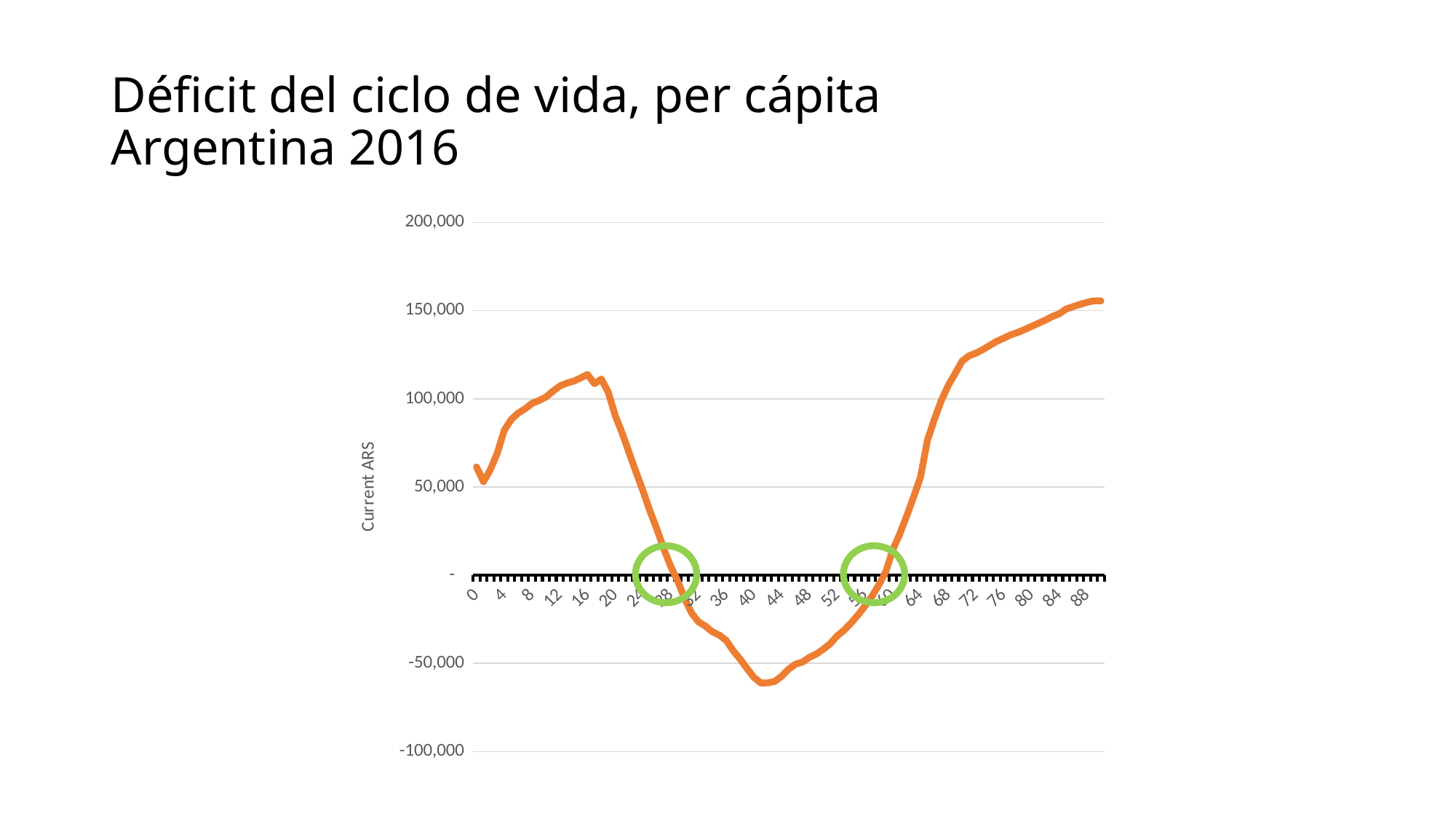
Is the value at age 80 greater or less than 150,000? less What is the title of the slide? Déficit del ciclo de vida, per cápita Argentina 2016 Do the values rise or fall between age 44 and age 88? rise What is the title of the y axis? Current ARS Which is larger, the value at age 16 or the value at age 88? age 88 Do the values rise or fall between age 20 and age 40? fall Is the value at age 16 greater or less than 100,000? greater What kind of chart is shown on the slide? line chart Is the value at age 40 greater or less than -50,000? less